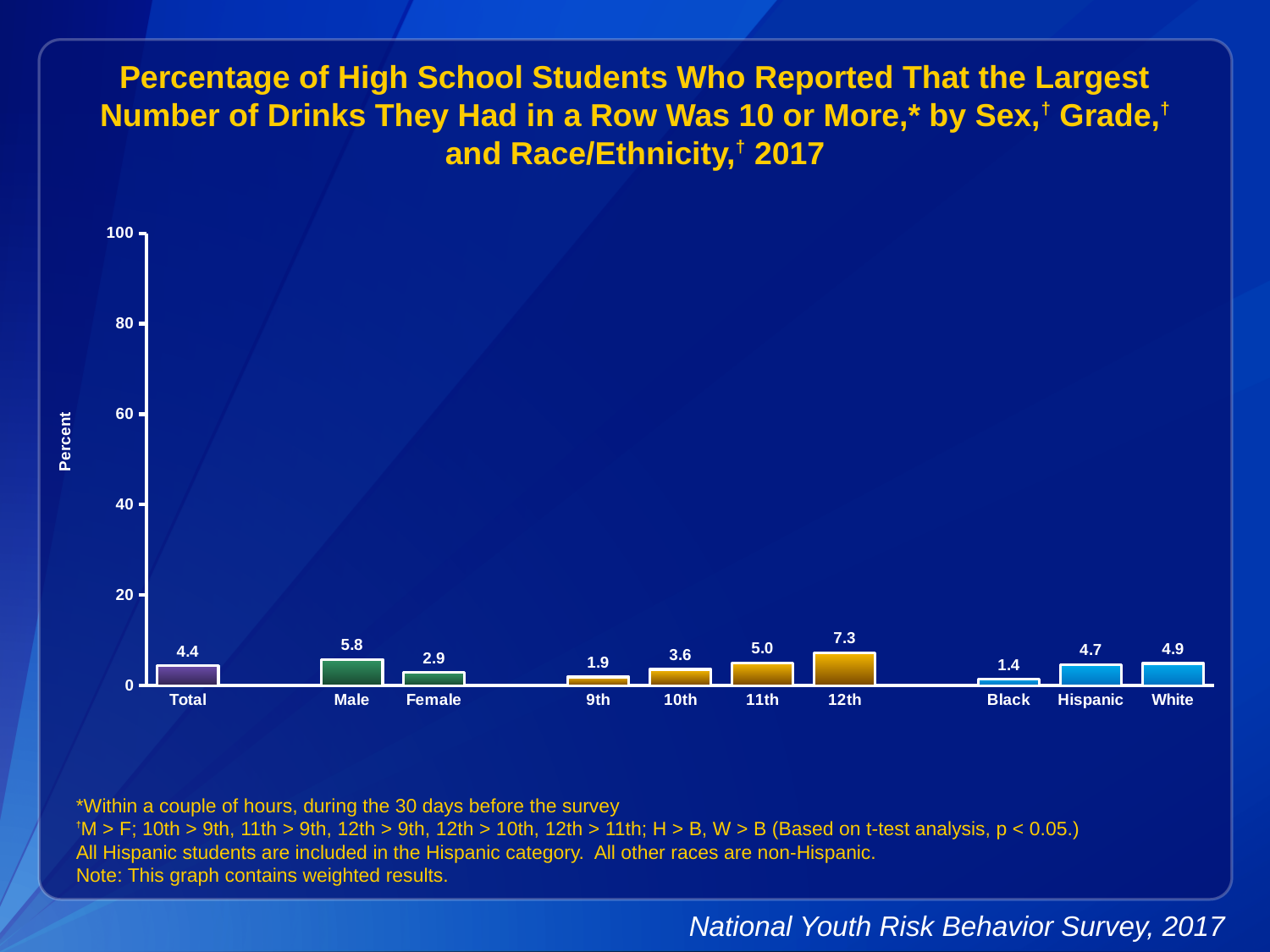
What is the value for Black students? 1.4 What kind of chart is this? bar chart Which is larger, the value for Hispanic or the value for White? White What is the value for 12th grade? 7.3 What is the value for Male? 5.8 How many categories are shown on the x axis? 10 What is the value for Total? 4.4 Do the values rise or fall from 9th grade to 12th grade? rise What is the difference between the Male and Female values? 2.9 Which category has the lowest value? Black Which category has the highest value? 12th Is the value for 12th grade greater or less than 20? less